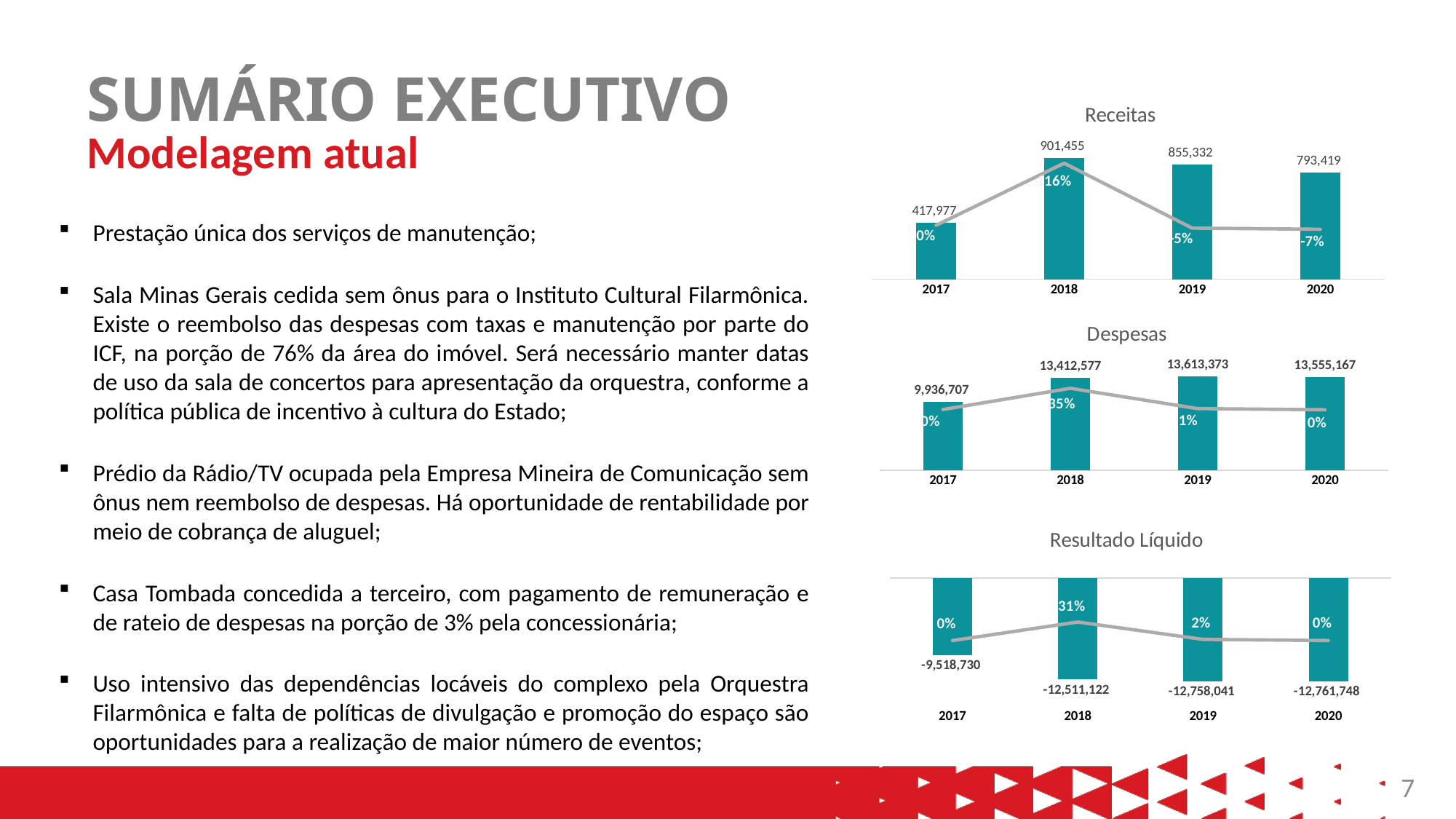
In the Resultado Líquido chart, which year has the value closest to zero (the highest value)? 2017 In the Despesas chart, what is the value for 2019? 13,613,373 In the Despesas chart, what percentage change is shown for 2018? 35% In the Receitas chart, what is the value for 2018? 901,455 In the Resultado Líquido chart, what is the value for 2020? -12,761,748 In the Despesas chart, which year has the highest value? 2019 In the Receitas chart, which year has the lowest value? 2017 In the Resultado Líquido chart, what is the difference between the 2017 and 2018 values? 2,992,392 What kind of chart is the Receitas chart? Bar chart with a line In the Receitas chart, what percentage change is shown for 2020? -7% How many years are shown on the x axis of the Despesas chart? 4 In the Receitas chart, what is the difference between the 2018 and 2019 values? 46,123